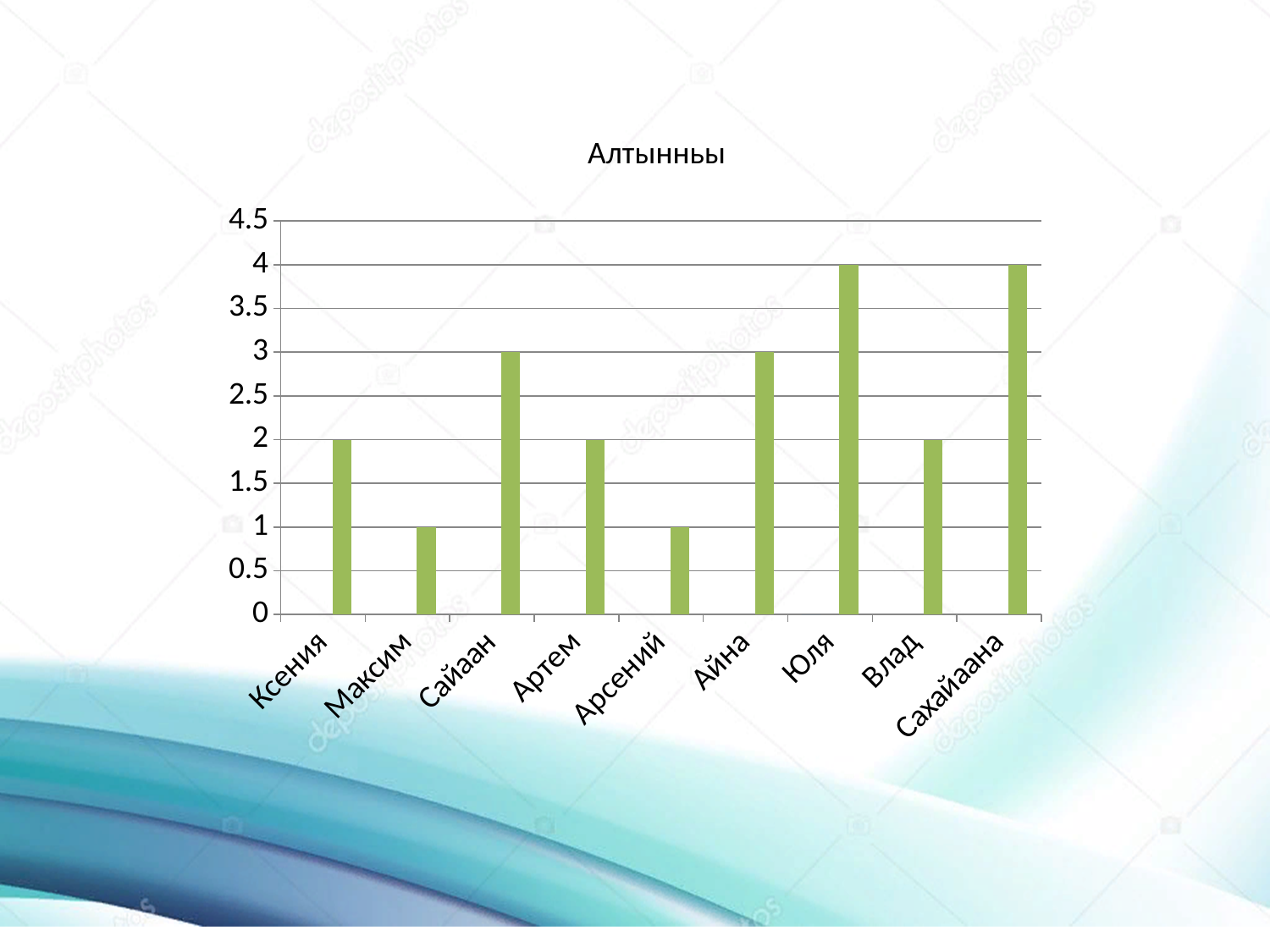
What is the value for Юля? 4 What is the value for Арсений? 1 What is the value for Сахайаана? 4 Which has a larger value, Сайаан or Артем? Сайаан What is the value for Сайаан? 3 How many categories are shown on the x axis of the chart? 9 What is the difference between the values for Юля and Максим? 3 Is the value for Влад greater or less than 3? less What is the title of the chart? Алтынньы What kind of chart is shown on the slide? bar chart What is the value for Ксения? 2 What colour are the bars in the chart? green